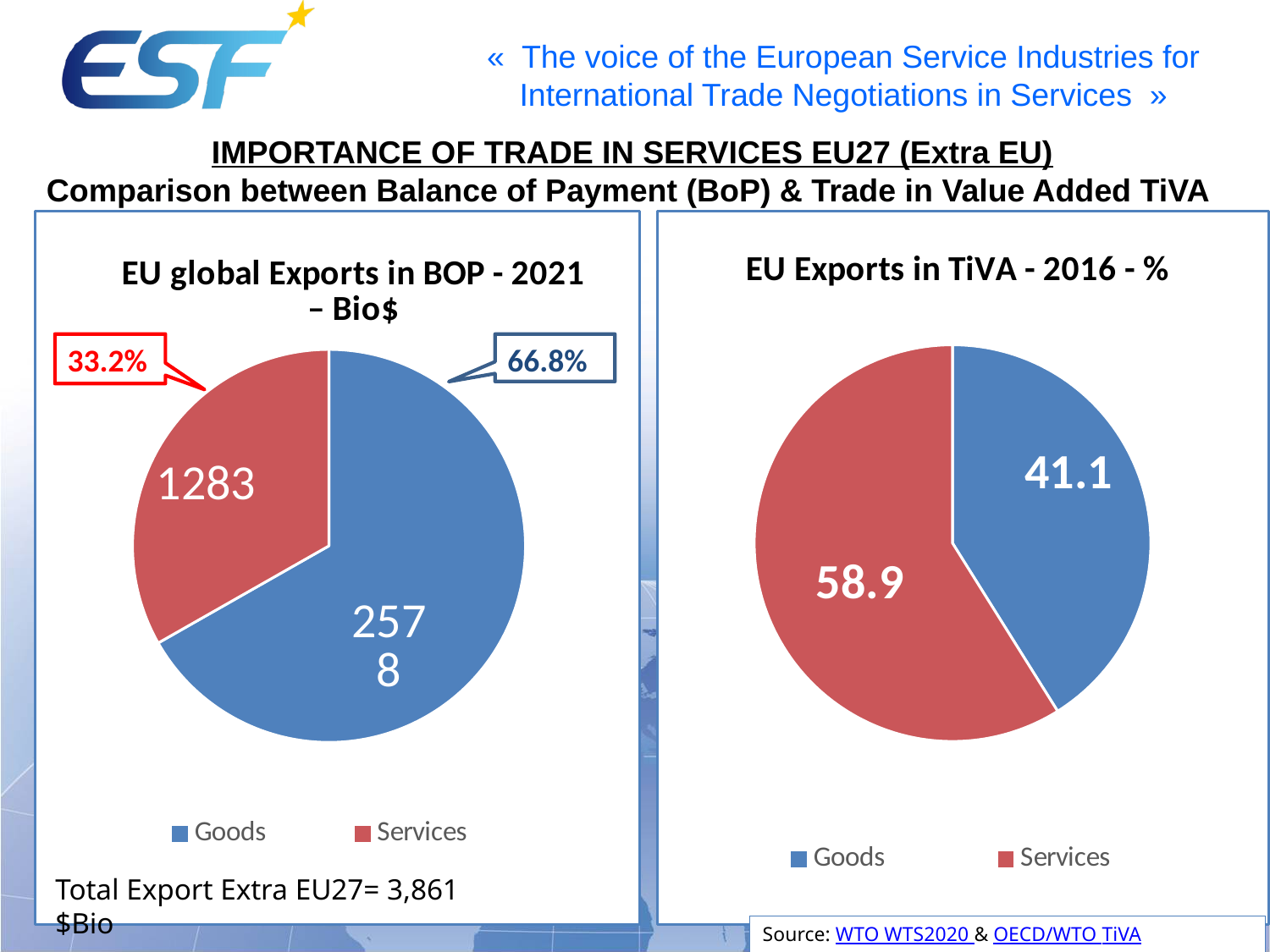
In the 'EU global Exports in BOP - 2021' chart, what percentage share is shown for Goods? 66.8% In the 'EU global Exports in BOP - 2021' chart, what is the value for Goods? 2578 What type of chart is the 'EU Exports in TiVA - 2016 - %' chart? pie chart How many categories does the legend of the 'EU global Exports in BOP - 2021' chart list? 2 In the 'EU Exports in TiVA - 2016 - %' chart, what is the value for Services? 58.9 In the 'EU Exports in TiVA - 2016 - %' chart, is the value for Services larger or smaller than the value for Goods? larger In the 'EU global Exports in BOP - 2021' chart, what is the difference between the Goods and Services values? 1295 In the 'EU Exports in TiVA - 2016 - %' chart, which category has the smaller slice? Goods In the 'EU Exports in TiVA - 2016 - %' chart, what is the value for Goods? 41.1 In the 'EU global Exports in BOP - 2021' chart, which category has the larger slice? Goods In the 'EU global Exports in BOP - 2021' chart, what percentage share is shown for Services? 33.2% In the 'EU global Exports in BOP - 2021' chart, what is the value for Services? 1283